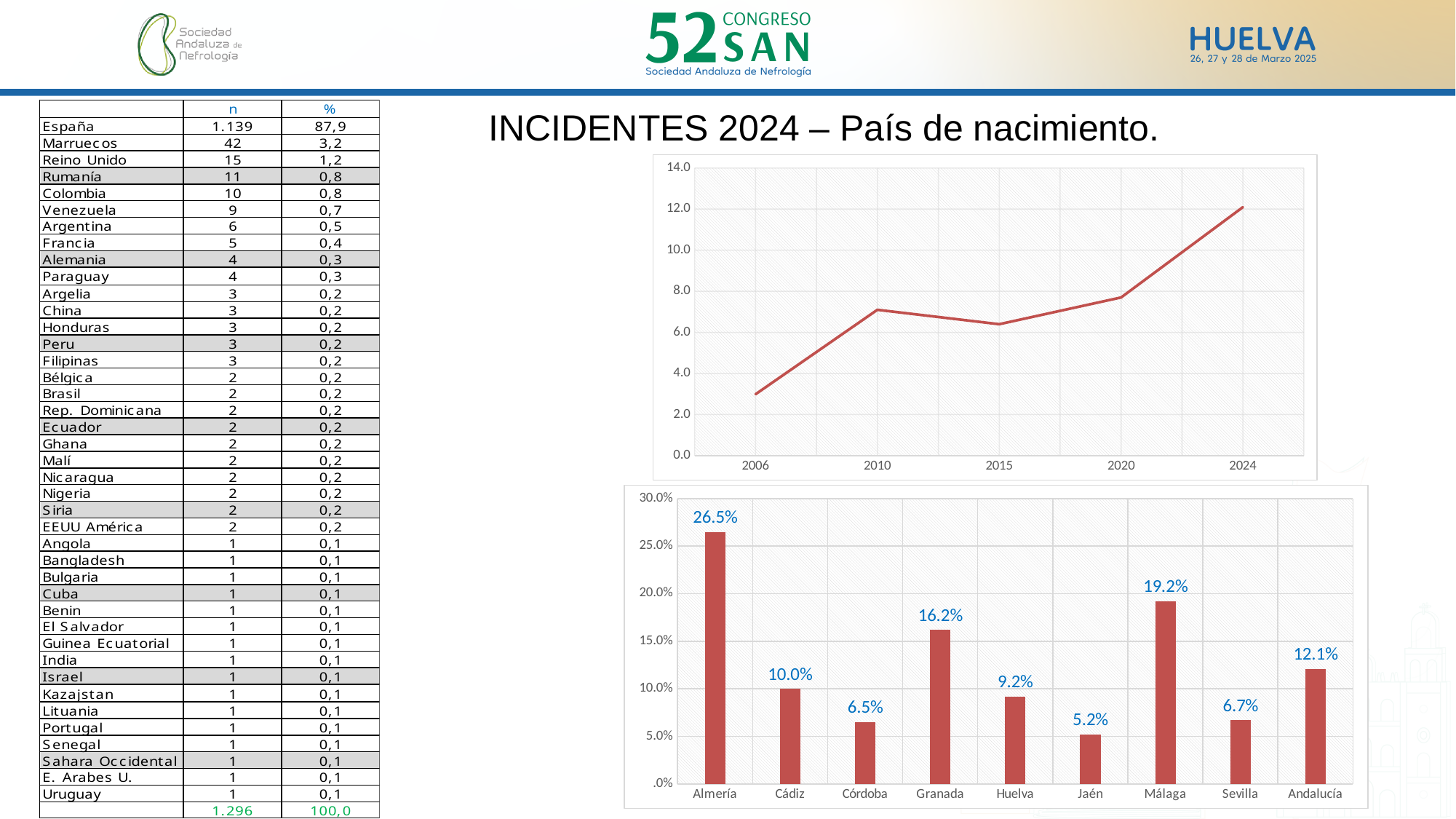
In the line chart at the top right of the slide, does the value rise or fall between 2020 and 2024? rise In the bar chart at the bottom of the slide, what is the value for Almería? 26.5% In the bar chart at the bottom of the slide, which category has the highest value? Almería In the line chart at the top right of the slide, is the value for 2006 greater or less than 4.0? less In the line chart at the top right of the slide, is the value for 2024 greater or less than 10.0? greater What kind of chart is the chart at the top right of the slide, with years on the x axis? line chart In the bar chart at the bottom of the slide, what is the value for Andalucía? 12.1% In the bar chart at the bottom of the slide, what is the difference between the values for Granada and Huelva? 7.0% In the bar chart at the bottom of the slide, which category has the lowest value? Jaén In the bar chart at the bottom of the slide, which is larger, the value for Córdoba or the value for Sevilla? Sevilla How many categories are shown on the x axis of the bar chart at the bottom of the slide? 9 In the bar chart at the bottom of the slide, what is the value for Málaga? 19.2%